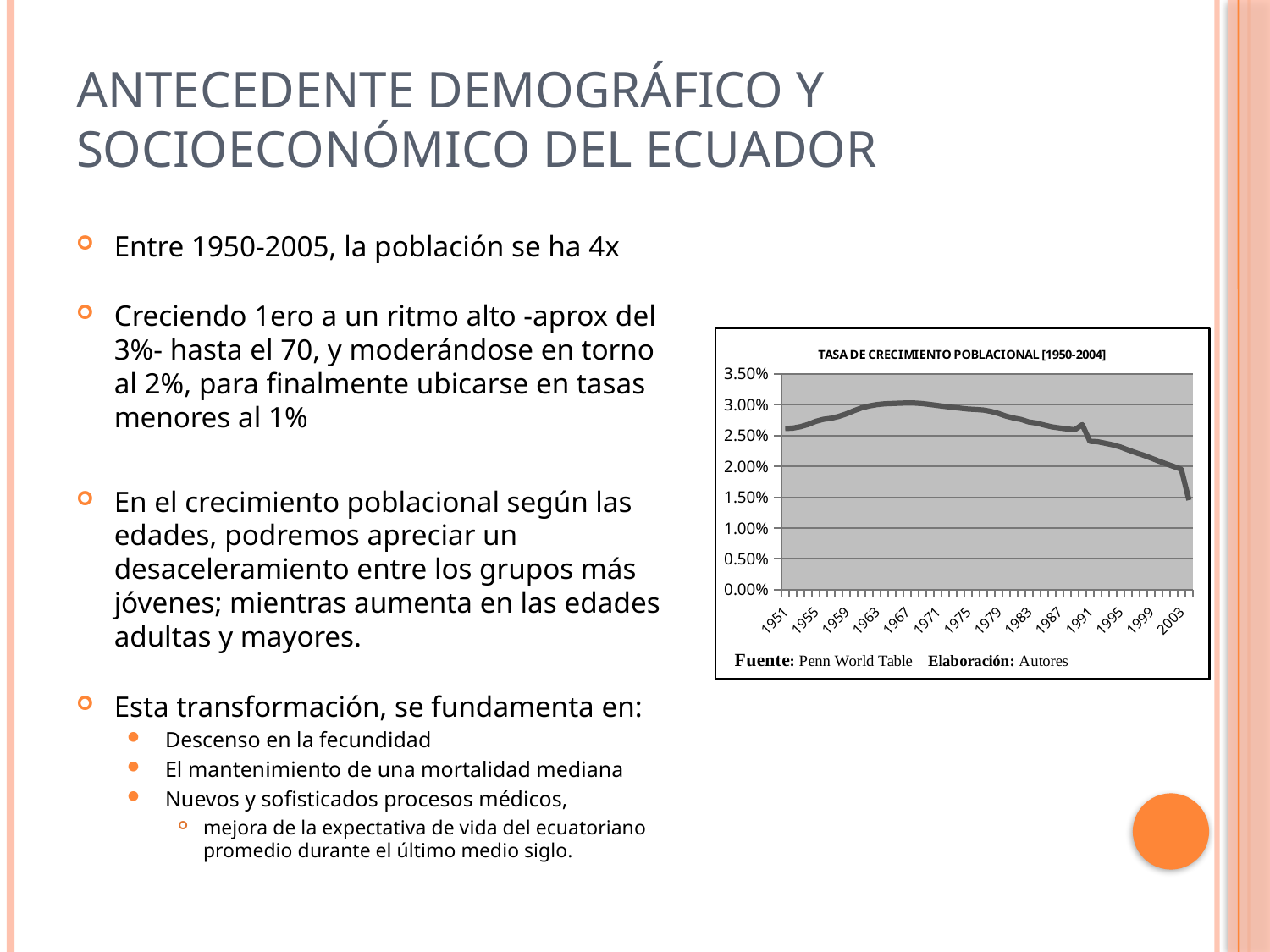
Which is larger, the growth rate in 1963 or in 1995? 1963 Which year labelled on the x axis has the lowest population growth rate? 2003 Which is larger, the growth rate in 1951 or in 2003? 1951 According to the chart's source note, what is the data source (Fuente)? Penn World Table What is the title of the chart on the slide? TASA DE CRECIMIENTO POBLACIONAL [1950-2004] What kind of chart is shown on the slide? Line chart Is the value for 1999 greater or less than 2.50%? less Is the value for 1967 greater or less than 2.50%? greater Is the value for 1951 greater or less than 2.00%? greater How many year labels are shown on the x axis? 14 Does the growth rate rise or fall between 1971 and 2003? fall